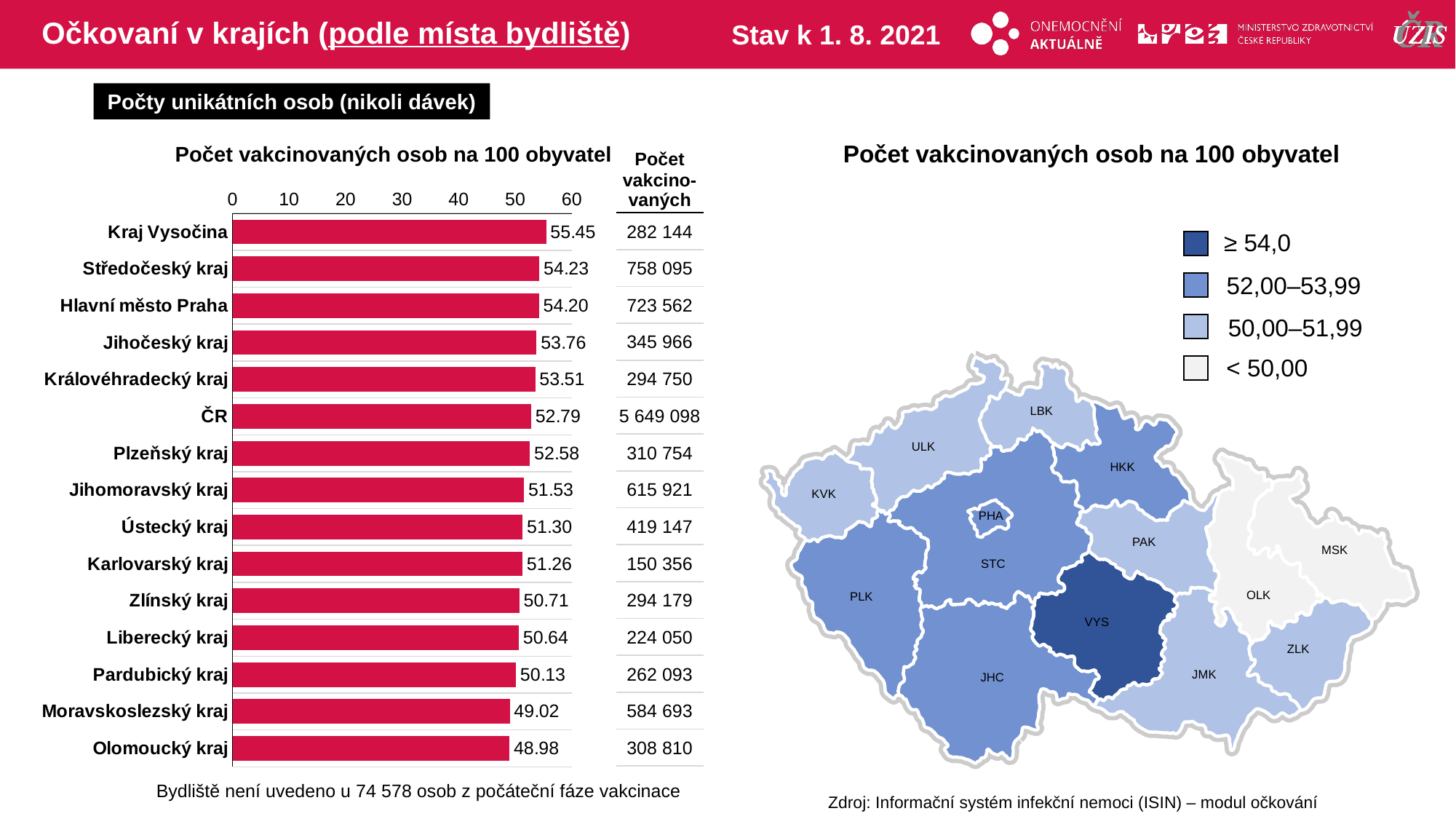
In the bar chart 'Počet vakcinovaných osob na 100 obyvatel', is the value for Moravskoslezský kraj greater or less than 50? less How many bars (categories) are shown in the bar chart 'Počet vakcinovaných osob na 100 obyvatel'? 15 In the column 'Počet vakcinovaných' next to the bar chart, what is the number for Středočeský kraj? 758 095 In the bar chart 'Počet vakcinovaných osob na 100 obyvatel', which is larger, the value for Jihočeský kraj or the value for Plzeňský kraj? Jihočeský kraj In the bar chart 'Počet vakcinovaných osob na 100 obyvatel', what is the difference between the values for Kraj Vysočina and Olomoucký kraj? 6.47 How many categories does the legend of the map 'Počet vakcinovaných osob na 100 obyvatel' list? 4 In the bar chart 'Počet vakcinovaných osob na 100 obyvatel', which region has the highest value? Kraj Vysočina In the bar chart 'Počet vakcinovaných osob na 100 obyvatel', what is the value for ČR? 52.79 In the bar chart 'Počet vakcinovaných osob na 100 obyvatel', what is the value for Liberecký kraj? 50.64 What kind of chart is used on the left side of the slide to show 'Počet vakcinovaných osob na 100 obyvatel'? bar chart In the bar chart 'Počet vakcinovaných osob na 100 obyvatel', what is the value for Kraj Vysočina? 55.45 In the bar chart 'Počet vakcinovaných osob na 100 obyvatel', which region has the lowest value? Olomoucký kraj